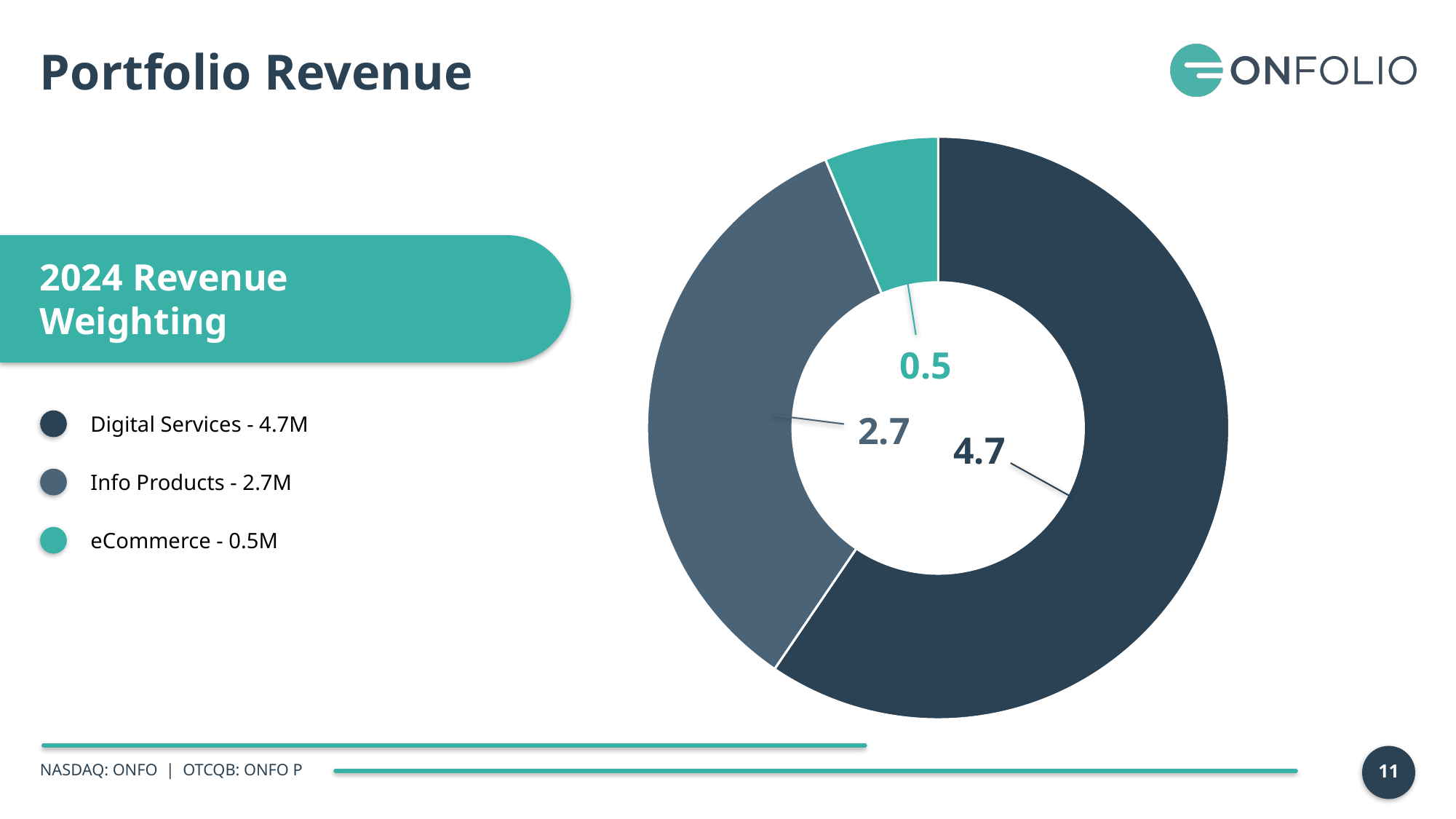
What kind of chart is used to show the 2024 Revenue Weighting? donut (pie) chart What is the total of the three values shown in the 2024 Revenue Weighting chart? 7.9 Which category has the smallest slice in the 2024 Revenue Weighting chart? eCommerce What colour represents eCommerce in the 2024 Revenue Weighting chart? teal How many categories are shown in the 2024 Revenue Weighting chart? 3 What is the difference between the Info Products value and the eCommerce value in the chart? 2.2 What is the difference between the Digital Services value and the Info Products value in the chart? 2.0 What is the value shown for Digital Services in the 2024 Revenue Weighting chart? 4.7 Which category has the largest slice in the 2024 Revenue Weighting chart? Digital Services What is the value shown for eCommerce in the 2024 Revenue Weighting chart? 0.5 What is the value shown for Info Products in the 2024 Revenue Weighting chart? 2.7 Which is larger in the chart, Info Products or eCommerce? Info Products